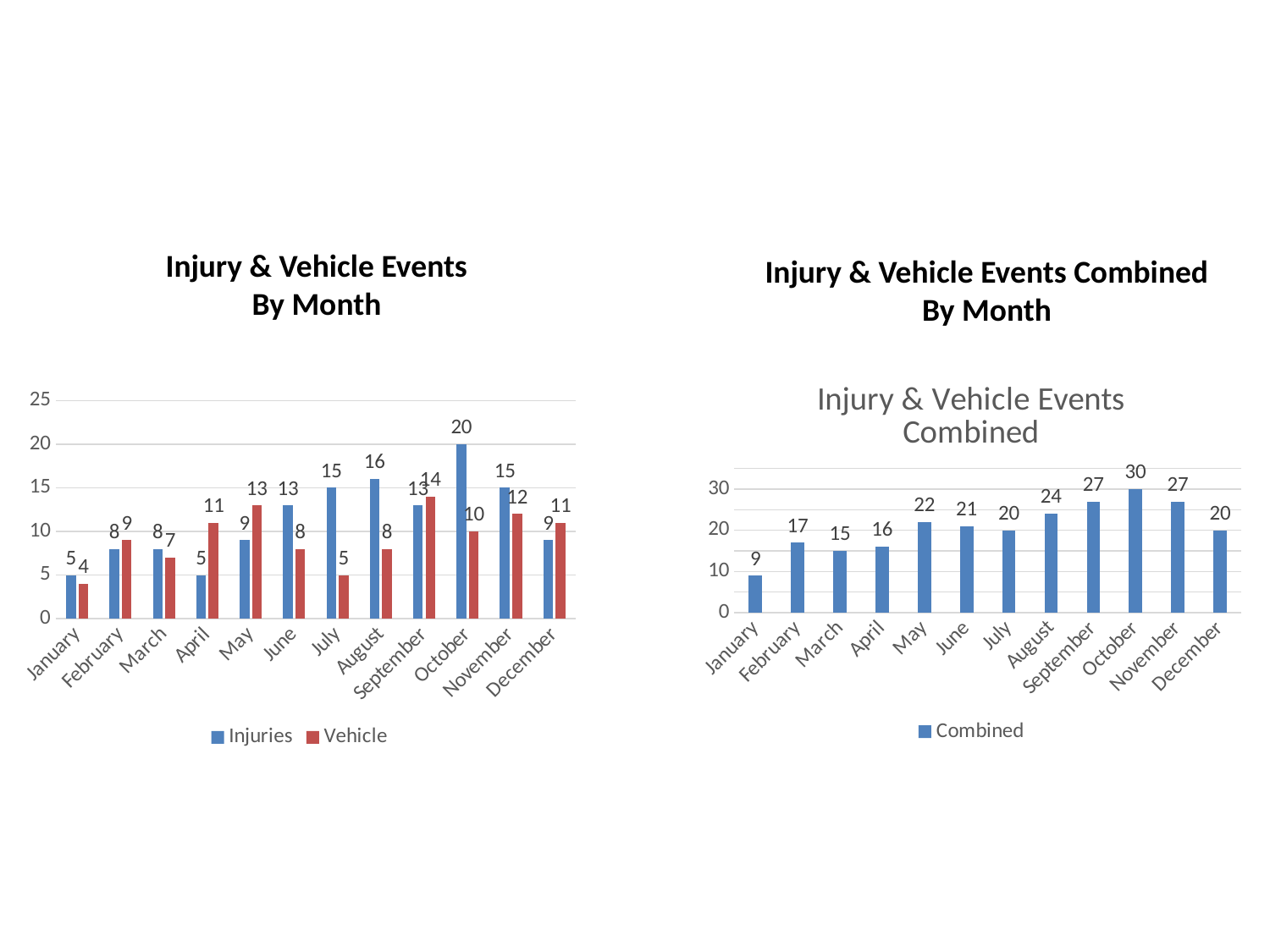
In the 'Injury & Vehicle Events By Month' chart, which is larger for May, Injuries or Vehicle? Vehicle How many series does the legend of the 'Injury & Vehicle Events By Month' chart list? 2 In the 'Injury & Vehicle Events Combined By Month' chart, what is the Combined value for September? 27 In the 'Injury & Vehicle Events By Month' chart, which month has the lowest Vehicle value? January In the 'Injury & Vehicle Events By Month' chart, what is the Vehicle value for April? 11 In the 'Injury & Vehicle Events Combined By Month' chart, which month has the lowest Combined value? January What kind of chart is the 'Injury & Vehicle Events Combined By Month' chart? Bar chart In the 'Injury & Vehicle Events By Month' chart, what is the Injuries value for October? 20 In the 'Injury & Vehicle Events By Month' chart, what is the difference between the Injuries and Vehicle values for July? 10 In the 'Injury & Vehicle Events By Month' chart, which month has the highest Injuries value? October How many months are shown on the x axis of the 'Injury & Vehicle Events Combined By Month' chart? 12 In the 'Injury & Vehicle Events Combined By Month' chart, what is the difference between the Combined values for October and December? 10